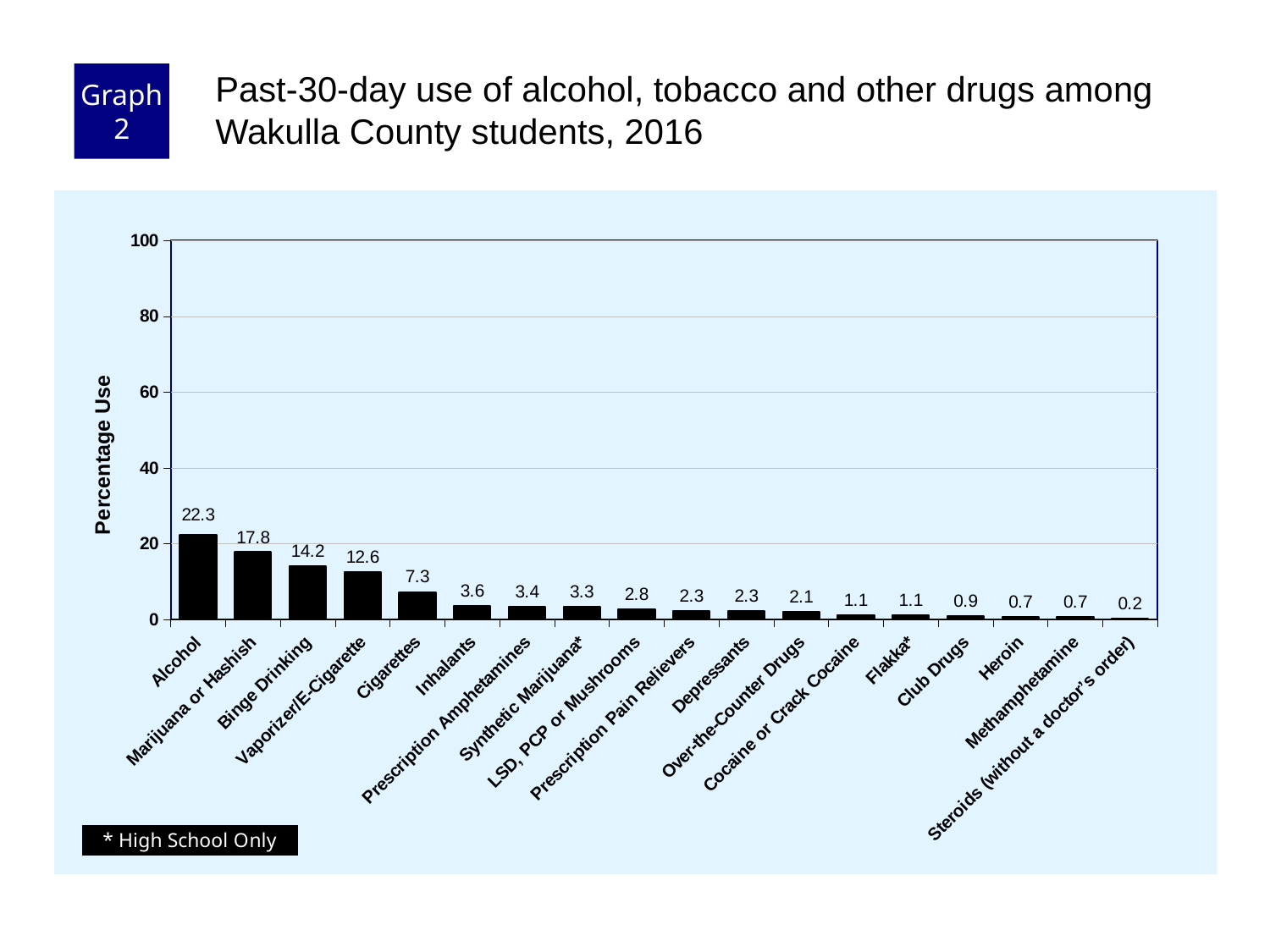
What is the value shown for Vaporizer/E-Cigarette? 12.6 How many categories are shown on the x axis? 18 What is the difference between the values for Alcohol and Marijuana or Hashish? 4.5 What is the value shown for Heroin? 0.7 What kind of chart is shown on the slide? bar chart What is the label of the y axis? Percentage Use What is the past-30-day use percentage for Alcohol? 22.3 Is the value for Marijuana or Hashish greater or less than 20? less What is the value shown for Cigarettes? 7.3 Which is larger, the value for Binge Drinking or the value for Cigarettes? Binge Drinking Which category has the lowest percentage use? Steroids (without a doctor's order) Which category has the highest percentage use? Alcohol